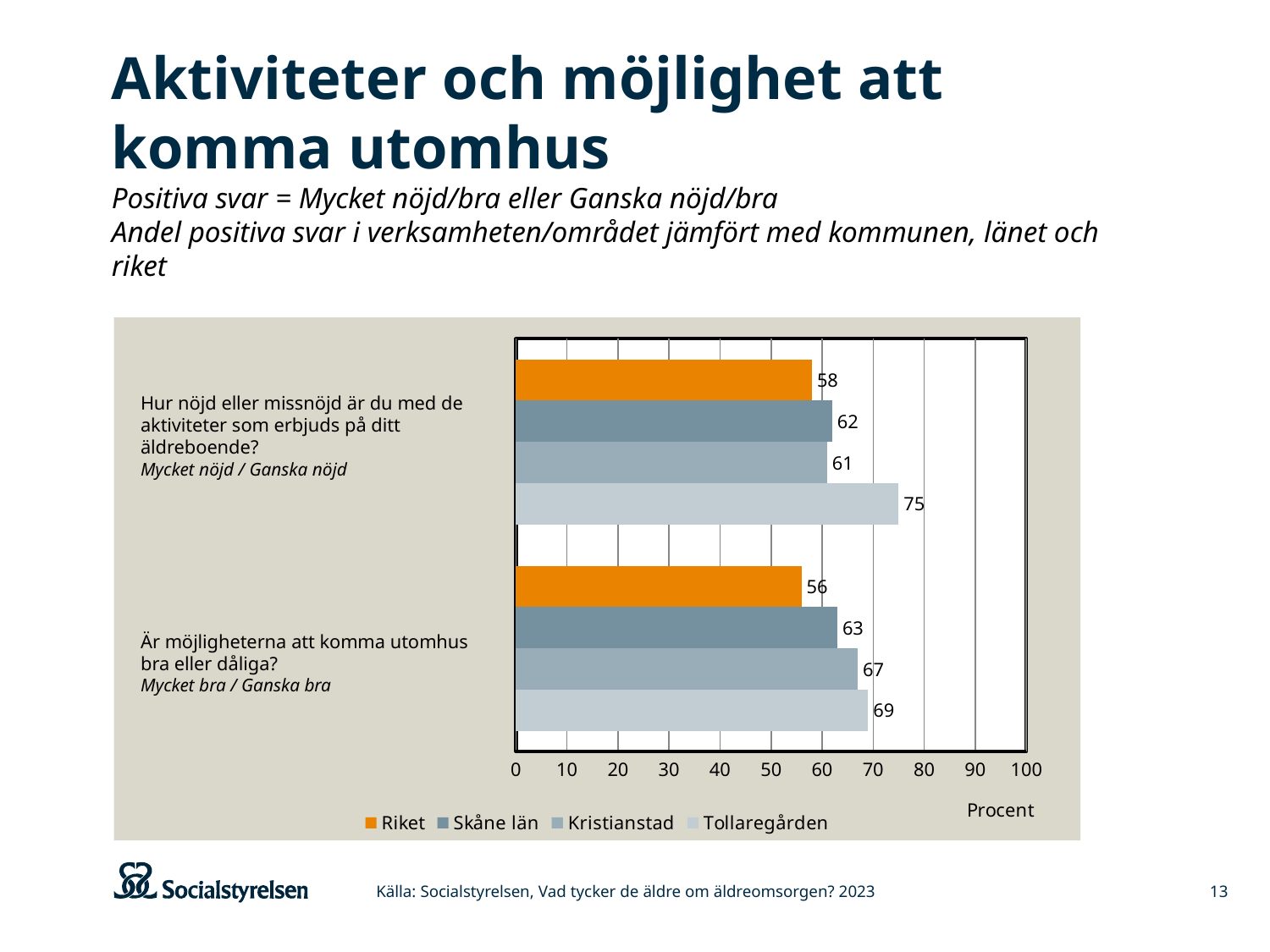
What is the value for Skåne län on the question about activities offered at the care home? 62 What is the difference between Tollaregården and Riket on the question about activities offered at the care home? 17 What is the value for Riket on the question about opportunities to get outdoors ("Är möjligheterna att komma utomhus bra eller dåliga?")? 56 What kind of chart is shown on the slide? Bar chart How many question categories are shown on the chart? 2 Which is larger on the question about opportunities to get outdoors: Skåne län or Kristianstad? Kristianstad Which series has the highest value on the question about activities offered at the care home? Tollaregården How many series does the legend list? 4 Which series has the lowest value on the question about opportunities to get outdoors? Riket What unit label is shown under the x axis of the chart? Procent What is the value for Kristianstad on the question about opportunities to get outdoors? 67 What is the value for Tollaregården on the question about activities offered at the care home ("Hur nöjd eller missnöjd är du med de aktiviteter som erbjuds på ditt äldreboende?")? 75